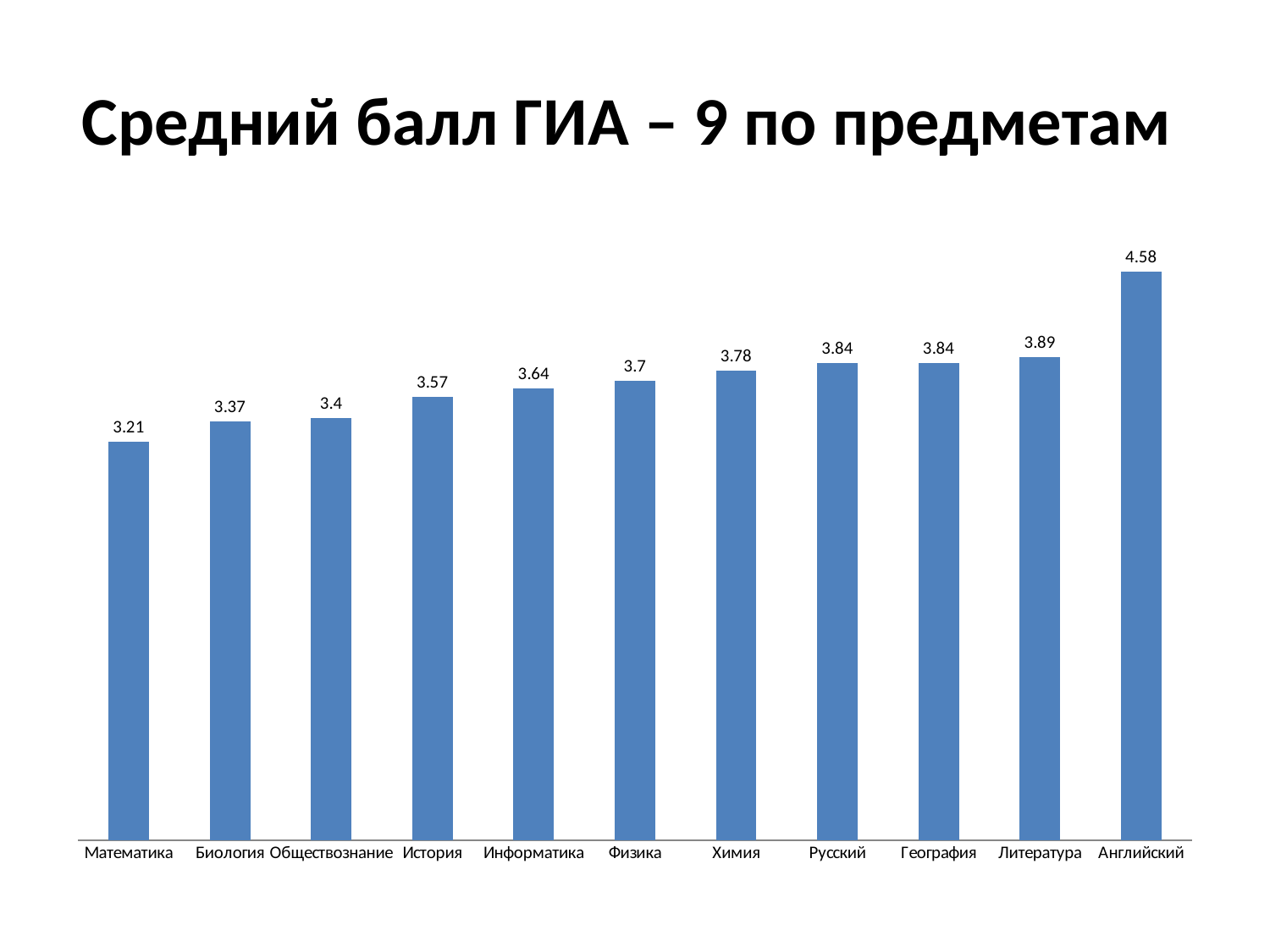
What is the average score for Математика? 3.21 What is the difference between the average scores for Химия and Физика? 0.08 Which subject has the lowest average score? Математика What is the average score for Литература? 3.89 Which subject has the highest average score? Английский What is the average score for Английский? 4.58 What type of chart is shown on the slide? Bar chart What is the average score for Информатика? 3.64 Do the values generally rise or fall from left to right across the subjects? Rise What is the difference between the average scores for Английский and Математика? 1.37 How many subjects are shown in the chart? 11 Which has a higher average score, История or Биология? История